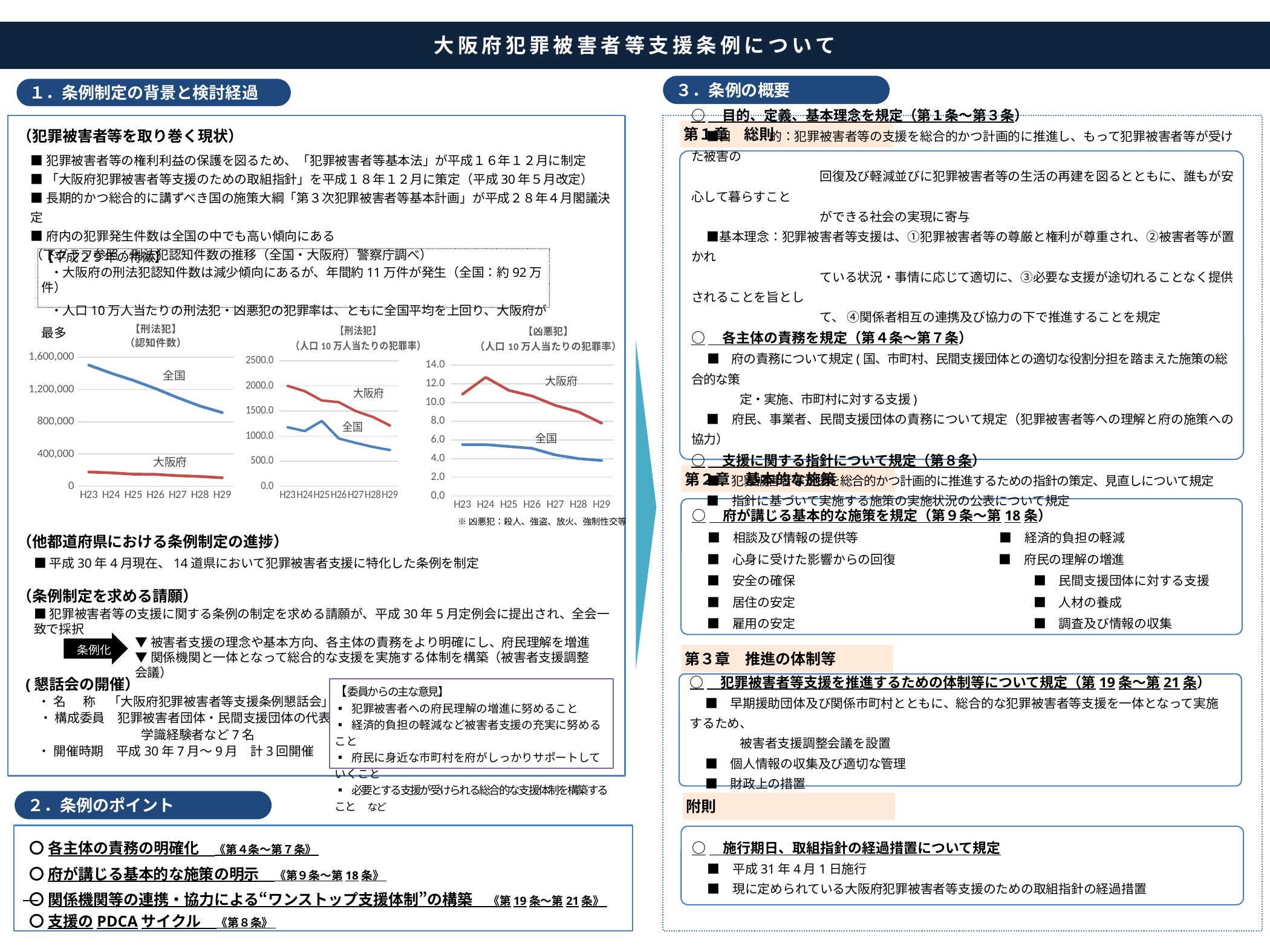
In the 【凶悪犯】（人口10万人当たりの犯罪率） chart, is the 全国 value for H23 greater or less than 6.0? less In the 【刑法犯】（人口10万人当たりの犯罪率） chart, is the 大阪府 value for H29 greater or less than 1000.0? greater In the 【刑法犯】（認知件数） chart, does the 全国 line rise or fall from H23 to H29? fall In the 【刑法犯】（人口10万人当たりの犯罪率） chart, in which year is the 全国 line at its highest? H25 In the 【刑法犯】（認知件数） chart, is the 大阪府 value for H29 greater or less than 400,000? less In the 【凶悪犯】（人口10万人当たりの犯罪率） chart, which is larger at H25, 大阪府 or 全国? 大阪府 What kind of chart is the 【刑法犯】（認知件数） chart? line chart How many years are plotted along the x axis of the 【刑法犯】（認知件数） chart? 7 In the 【凶悪犯】（人口10万人当たりの犯罪率） chart, in which year is the 大阪府 line at its highest? H24 What colour is the 大阪府 line in the 【刑法犯】（認知件数） chart? red